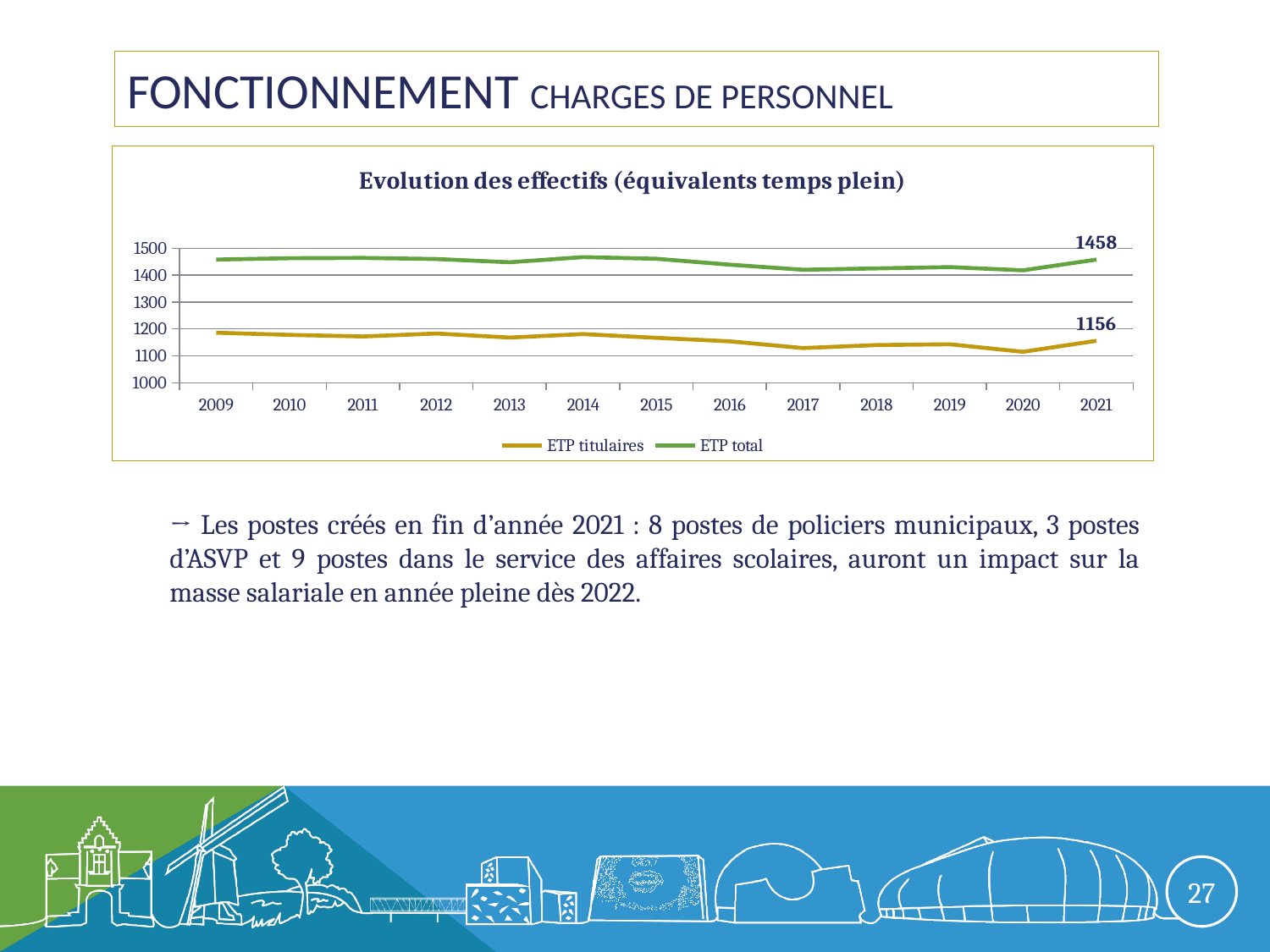
What is the value of ETP total in 2021? 1458 How many series does the legend list? 2 Is the value for ETP titulaires in 2020 greater or less than 1200? less What is the value of ETP titulaires in 2021? 1156 Is the value for ETP total in 2009 greater or less than 1400? greater Is the value for ETP titulaires in 2009 greater or less than 1100? greater What is the difference between ETP total and ETP titulaires in 2021? 302 Does the ETP titulaires line rise or fall from 2020 to 2021? Rise What is the title of the chart? Evolution des effectifs (équivalents temps plein) How many years are shown on the x axis of the chart? 13 What kind of chart is shown on the slide? Line chart In 2021, which series has the larger value, ETP total or ETP titulaires? ETP total